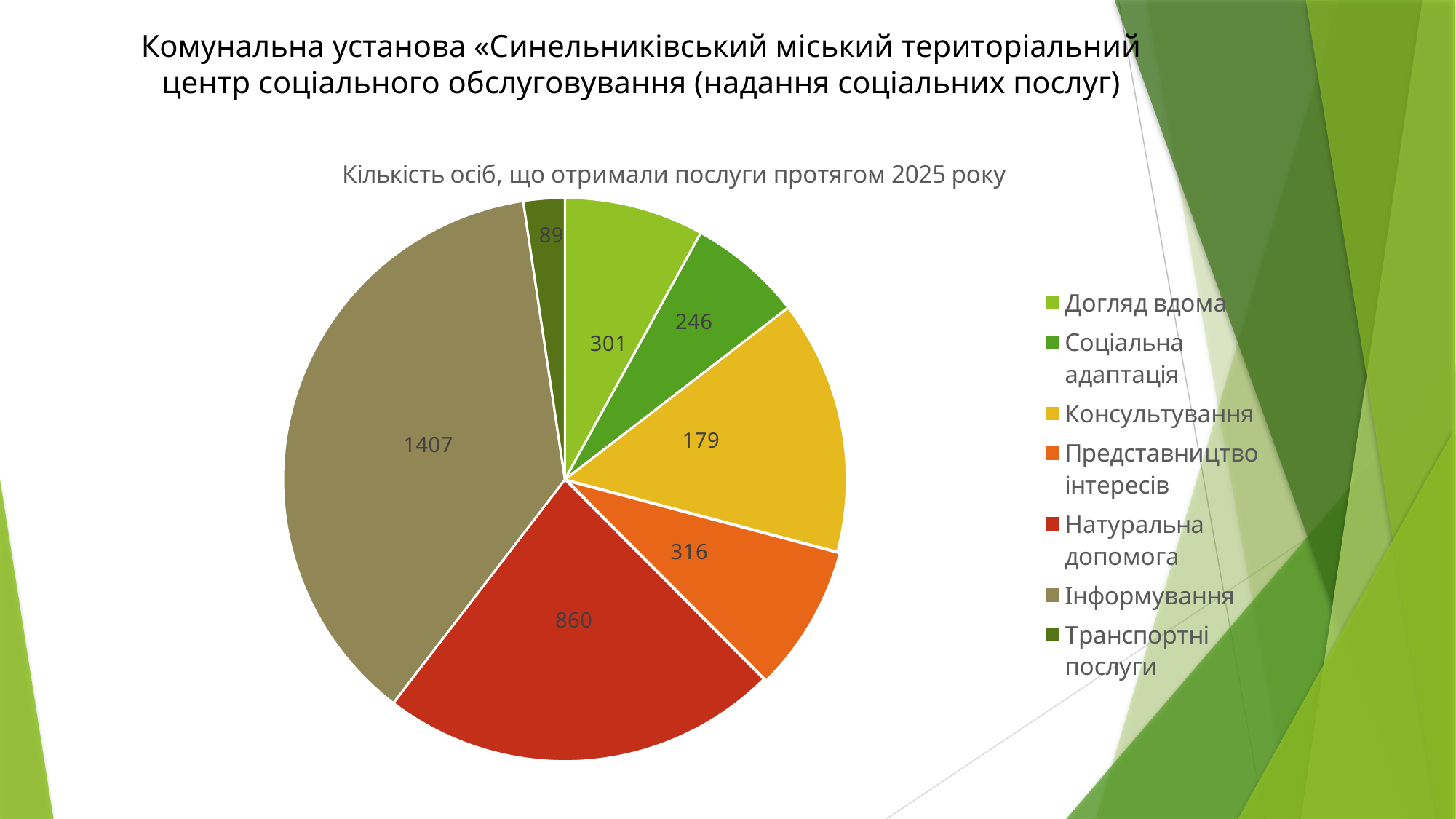
Which category has the lowest value? Транспортні послуги What is the difference between the values for Інформування and Натуральна допомога? 547 Which is larger, the value for Догляд вдома or the value for Соціальна адаптація? Догляд вдома What is the title of the chart? Кількість осіб, що отримали послуги протягом 2025 року How many categories (slices) does the pie chart have? 7 What kind of chart is shown on the slide? Pie chart What is the value for Транспортні послуги? 89 What is the value for Натуральна допомога? 860 What is the value for Догляд вдома? 301 Which category has the highest value? Інформування What is the value for Інформування? 1407 What is the value for Соціальна адаптація? 246